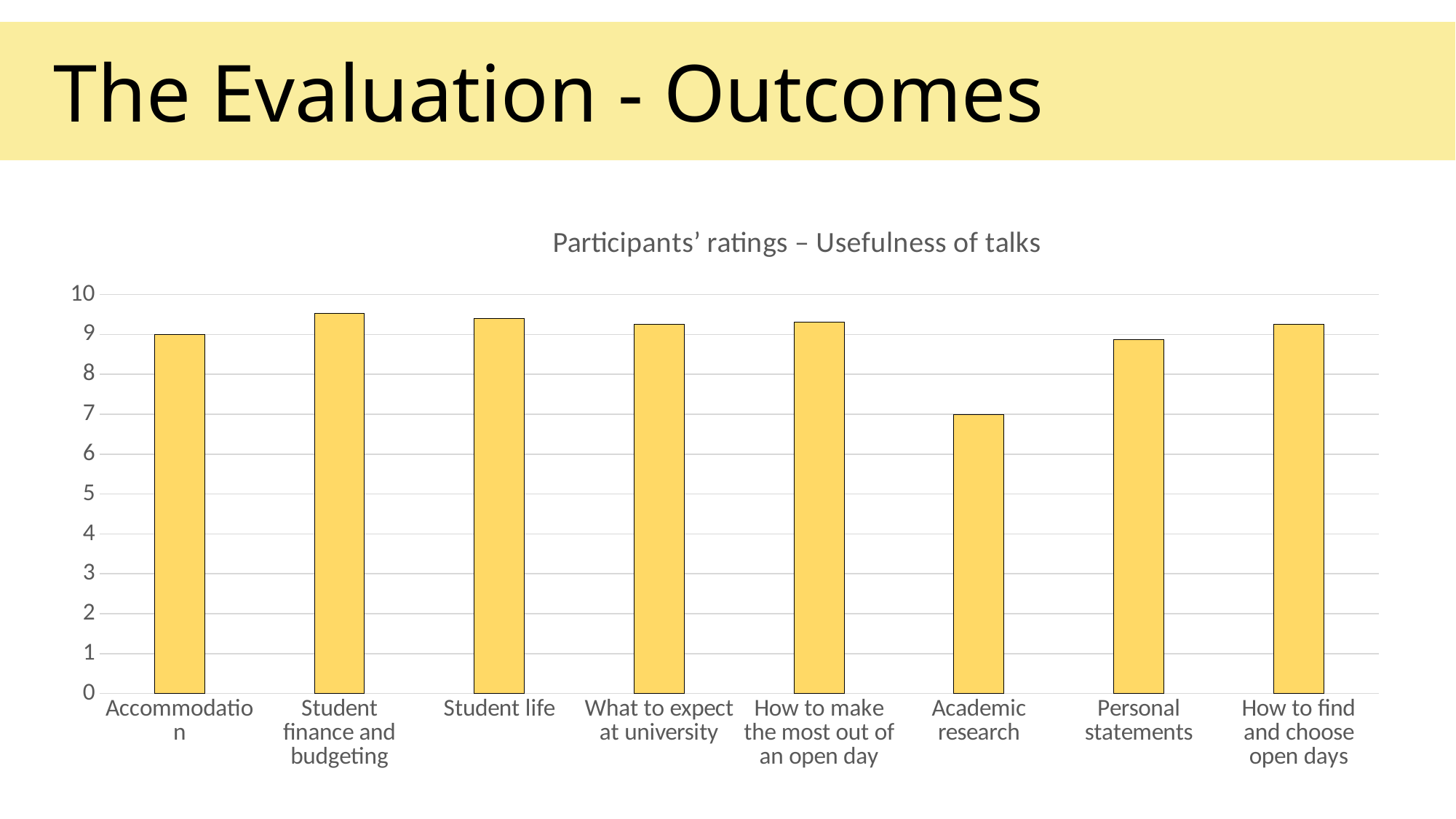
Which has the higher rating, Accommodation or Student finance and budgeting? Student finance and budgeting How many talk categories are shown on the x axis of the chart? 8 Which has the higher rating, Academic research or Personal statements? Personal statements Which talk received the lowest usefulness rating? Academic research What is the rating for Academic research? 7 What kind of chart is shown on the slide? bar chart What is the title of the chart? Participants’ ratings – Usefulness of talks What is the highest value shown on the vertical axis of the chart? 10 Is the rating for Personal statements greater or less than 9? less What is the rating for Accommodation? 9 Is the rating for Student finance and budgeting greater or less than 9? greater Is the rating for Student life greater or less than 9? greater